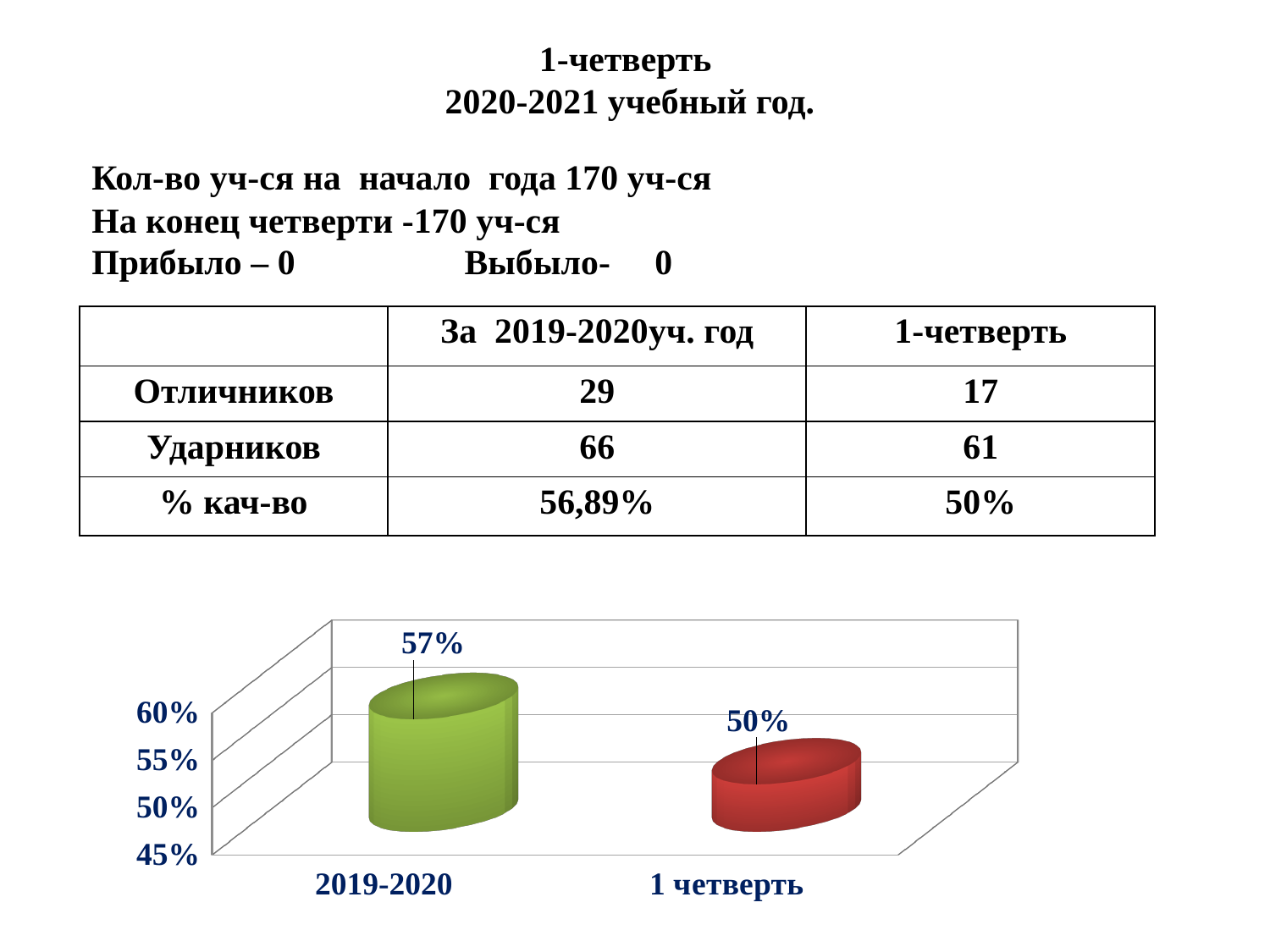
Which is larger in the chart: the value for 2019-2020 or the value for 1 четверть? 2019-2020 What kind of chart is shown on the slide? bar chart Do the values rise or fall from 2019-2020 to 1 четверть in the chart? fall What is the difference between the values for 2019-2020 and 1 четверть in the chart? 7% What is the lowest value labelled on the vertical axis of the chart? 45% Which category has the lowest value in the chart? 1 четверть What colour is the bar for 1 четверть in the chart? red Is the value for 2019-2020 in the chart greater or less than 55%? greater What is the value shown for 2019-2020 in the chart? 57% Which category has the highest value in the chart? 2019-2020 How many categories are shown on the x axis of the chart? 2 What is the value shown for 1 четверть in the chart? 50%